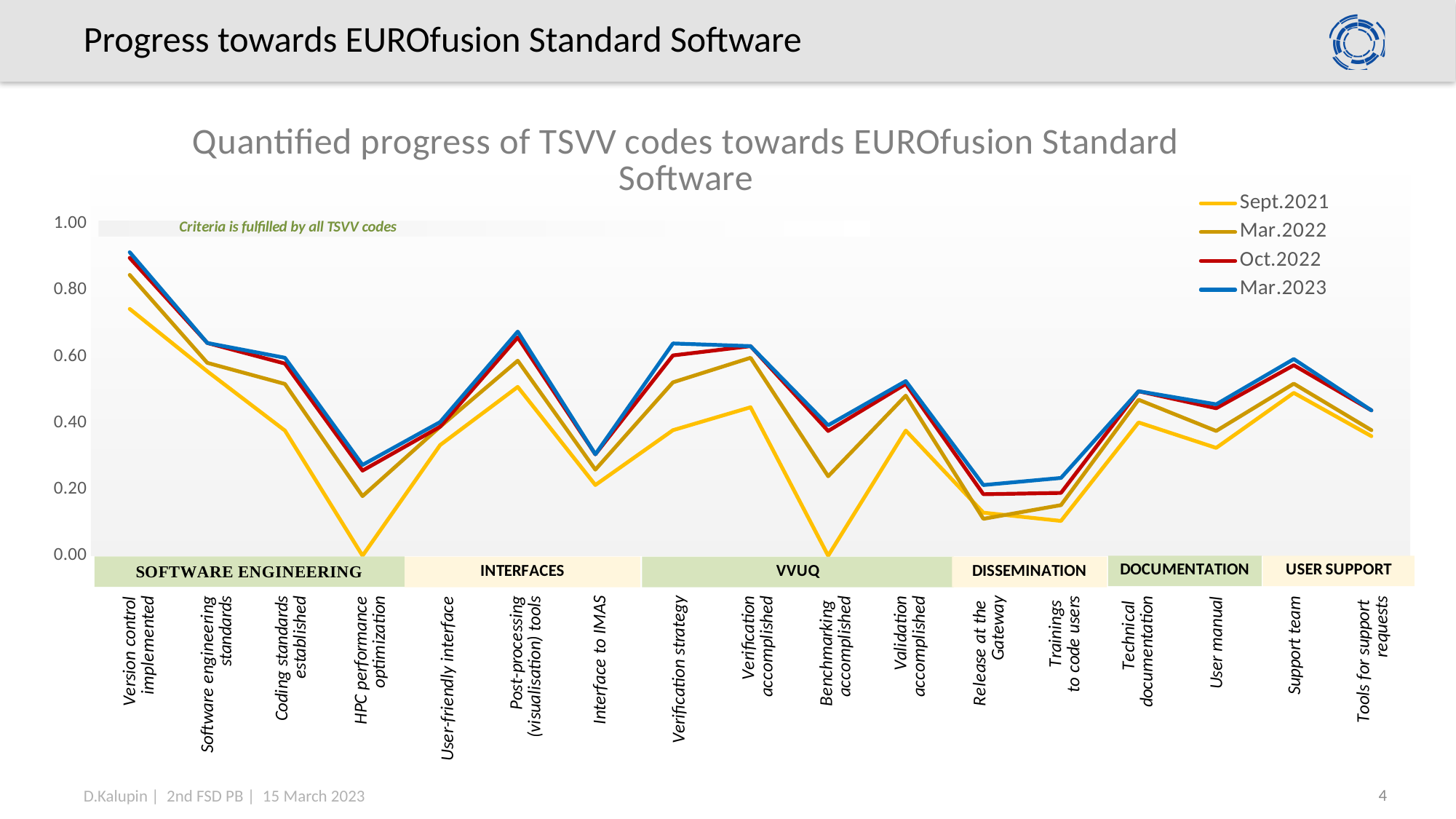
Is the Mar.2023 value for Version control implemented greater or less than 0.80? greater For the Mar.2023 series, which category has the highest value? Version control implemented For Version control implemented, which is larger: the Mar.2023 value or the Sept.2021 value? Mar.2023 What is the Sept.2021 value for HPC performance optimization? 0.00 Is the Mar.2023 value for Release at the Gateway greater or less than 0.40? less Which series is drawn in blue in the legend? Mar.2023 How many series does the legend list? 4 What kind of chart is shown on the slide? line chart Is the Mar.2023 value for HPC performance optimization greater or less than 0.40? less For the Sept.2021 series, which category has the highest value? Version control implemented What is the Sept.2021 value for Benchmarking accomplished? 0.00 How many categories are plotted along the x axis? 17